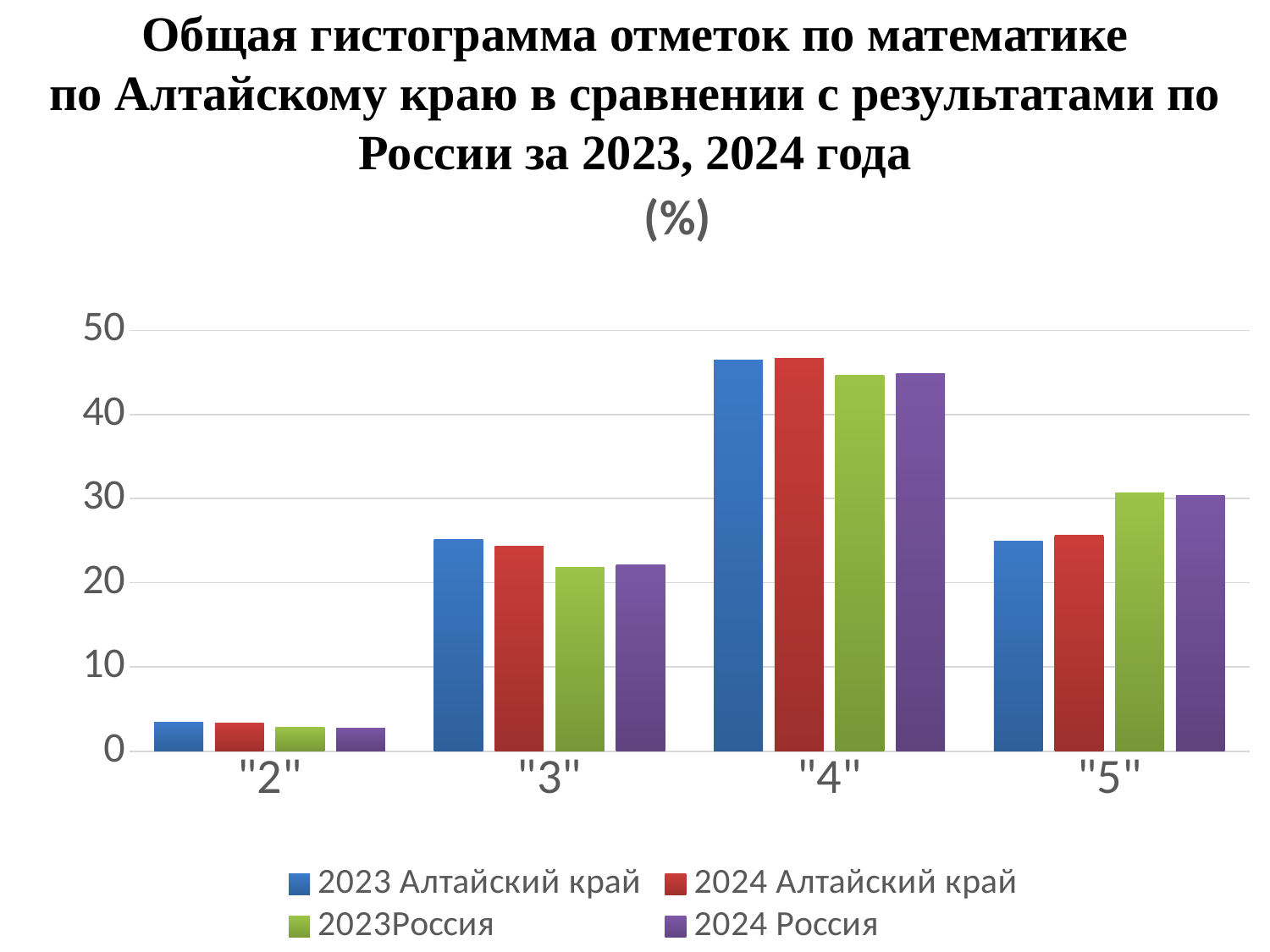
How many series does the legend list? 4 In category "3", which is larger: 2023 Алтайский край or 2023 Россия? 2023 Алтайский край For the series 2024 Россия, which category has the lowest value? "2" Is the value for 2023 Россия in category "2" greater or less than 10? less Is the value for 2024 Россия in category "3" greater or less than 20? greater How many categories are shown on the x axis? 4 Which colour represents the series 2024 Алтайский край in the legend? red For the series 2023 Алтайский край, which category has the highest value? "4" What kind of chart is shown on the slide? bar chart Is the value for 2024 Алтайский край in category "5" greater or less than 30? less In category "5", which is larger: 2023 Алтайский край or 2023 Россия? 2023 Россия